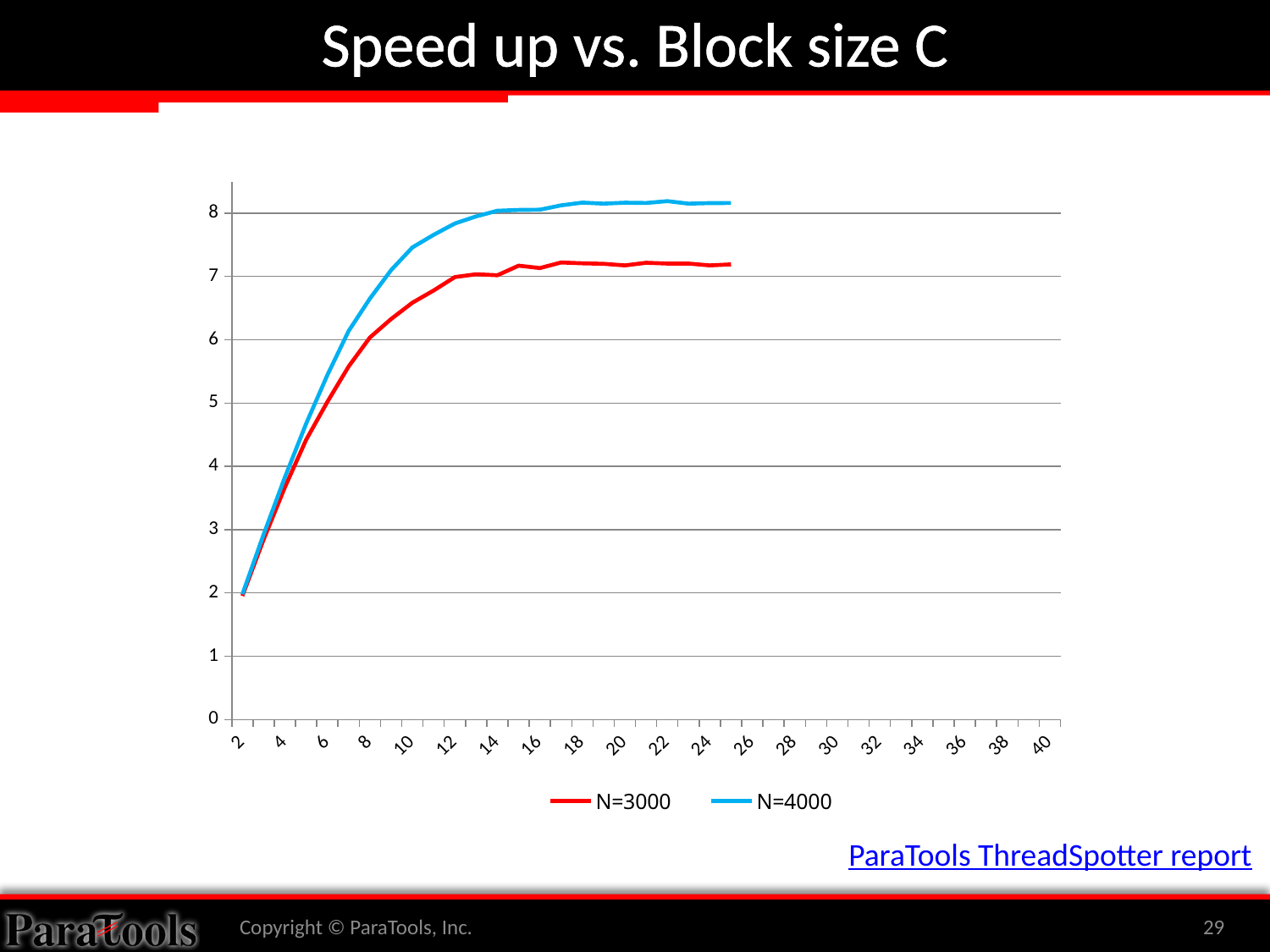
How many series does the legend list? 2 Is the value for N=4000 at block size 10 greater or less than 7? greater Is the value for N=4000 at block size 6 greater or less than 5? greater What kind of chart is shown on the slide? line chart At block size 20, which series has the larger value, N=3000 or N=4000? N=4000 Is the value for N=3000 at block size 20 greater or less than 7? greater How does the N=4000 series change as block size increases from 2 to about 14? it rises What is the title of the chart? Speed up vs. Block size C Which series reaches the higher speed up, N=3000 or N=4000? N=4000 What are the two series named in the legend? N=3000 and N=4000